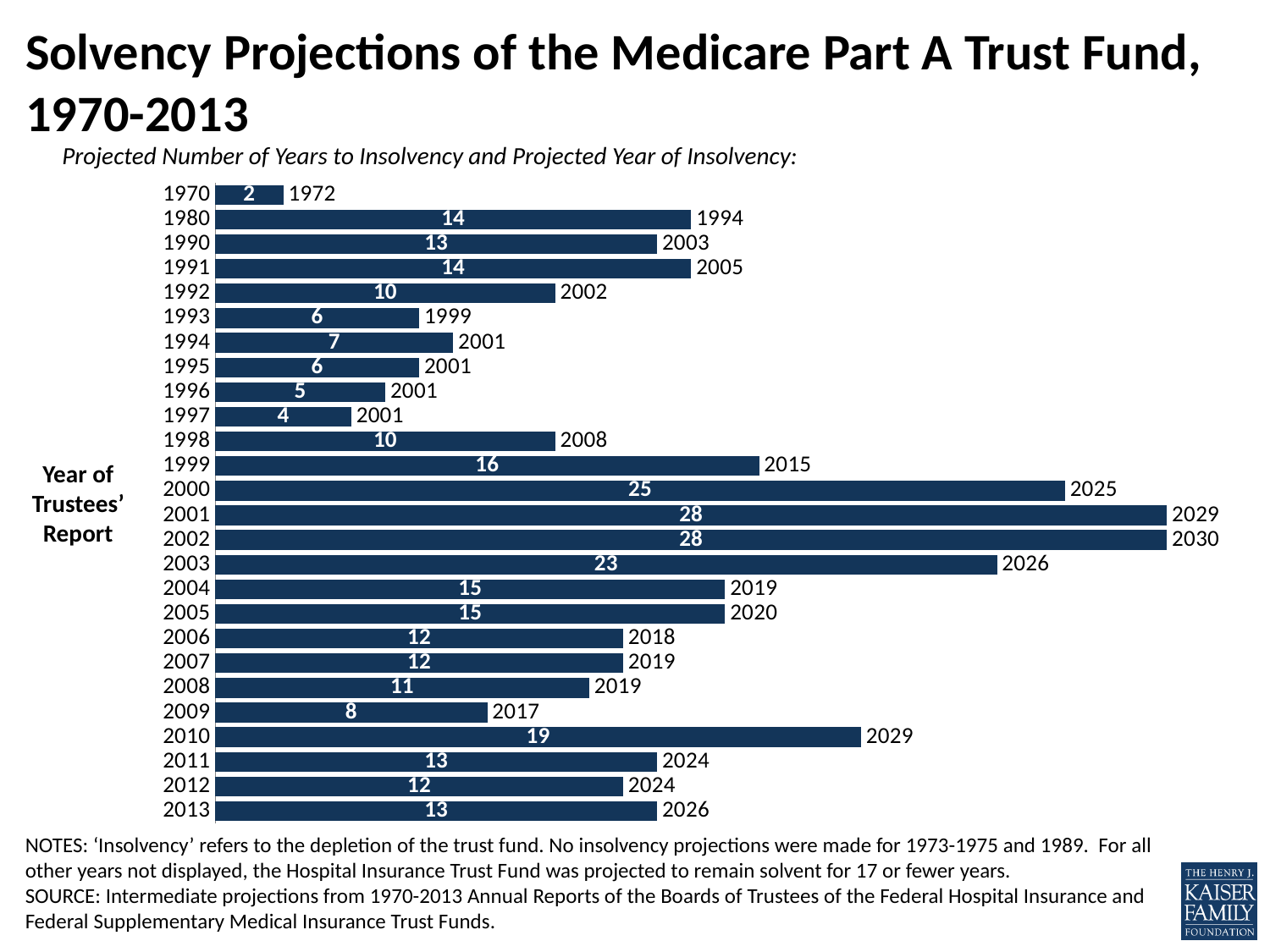
What is the projected year of insolvency shown for the 1970 Trustees' Report? 1972 What is the difference in projected years to insolvency between the 2001 and 2009 Trustees' Reports? 20 What is the projected number of years to insolvency in the 2010 Trustees' Report? 19 What is the projected number of years to insolvency in the 2000 Trustees' Report? 25 What type of chart is shown on the slide? bar chart Which Trustees' Report year has the lowest projected number of years to insolvency? 1970 What is the highest projected number of years to insolvency shown on the chart? 28 Which has a larger projected number of years to insolvency, the 1999 Trustees' Report or the 2004 Trustees' Report? 1999 What is the projected year of insolvency shown for the 2013 Trustees' Report? 2026 What is the difference in projected years to insolvency between the 1980 and 1997 Trustees' Reports? 10 How many Trustees' Report years are shown on the chart? 26 What label is shown on the vertical axis of the chart? Year of Trustees' Report